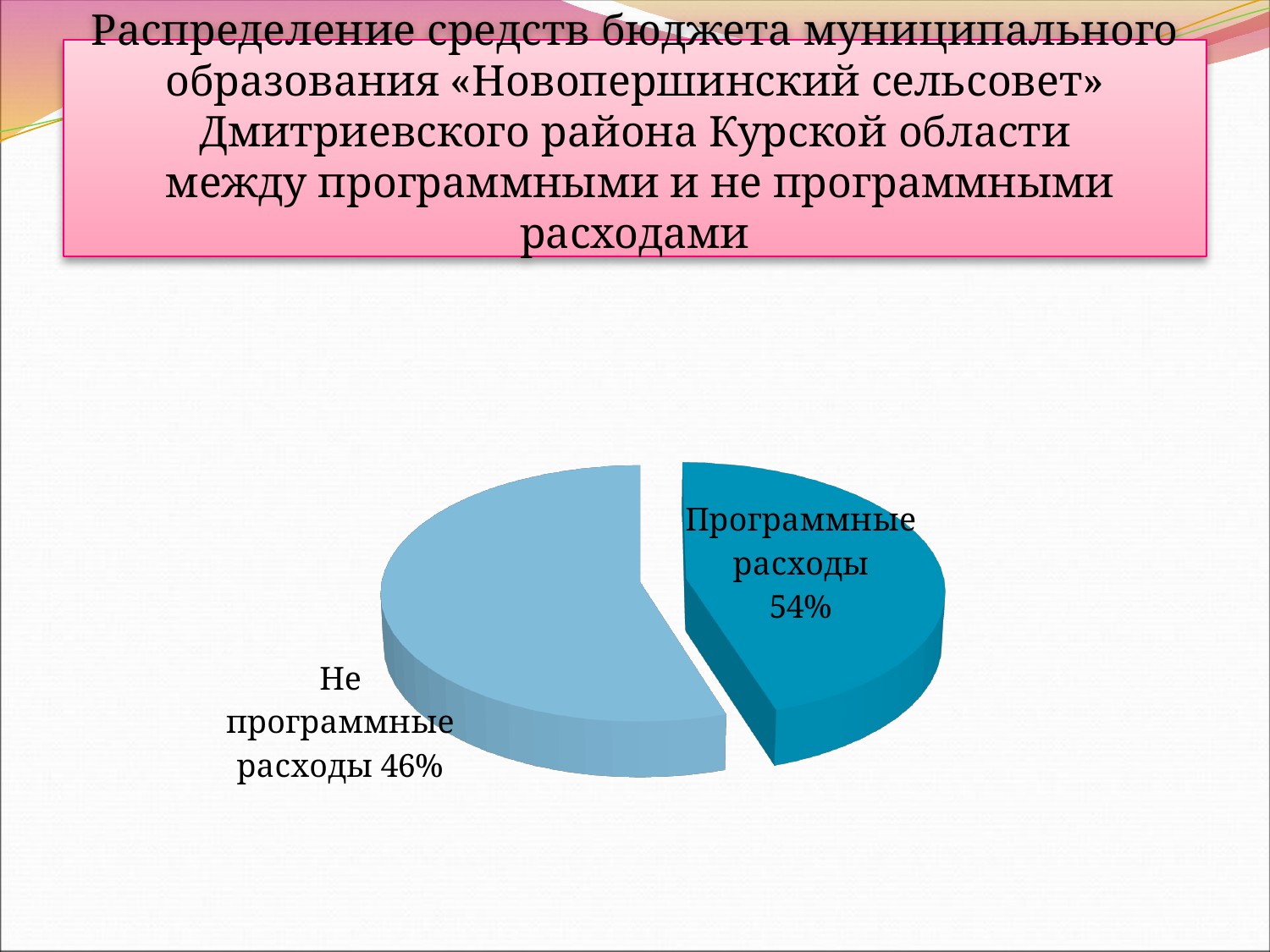
Which slice of the pie is shown in the darker blue colour? Программные расходы What share of the pie is labelled "Не программные расходы"? 46% What is the total of the two percentages shown on the pie chart? 100% What kind of chart is shown on the slide? Pie chart What is the difference in percentage points between the "Программные расходы" and "Не программные расходы" slices? 8 How many slices does the pie chart have? 2 What share of the pie is labelled "Программные расходы"? 54%